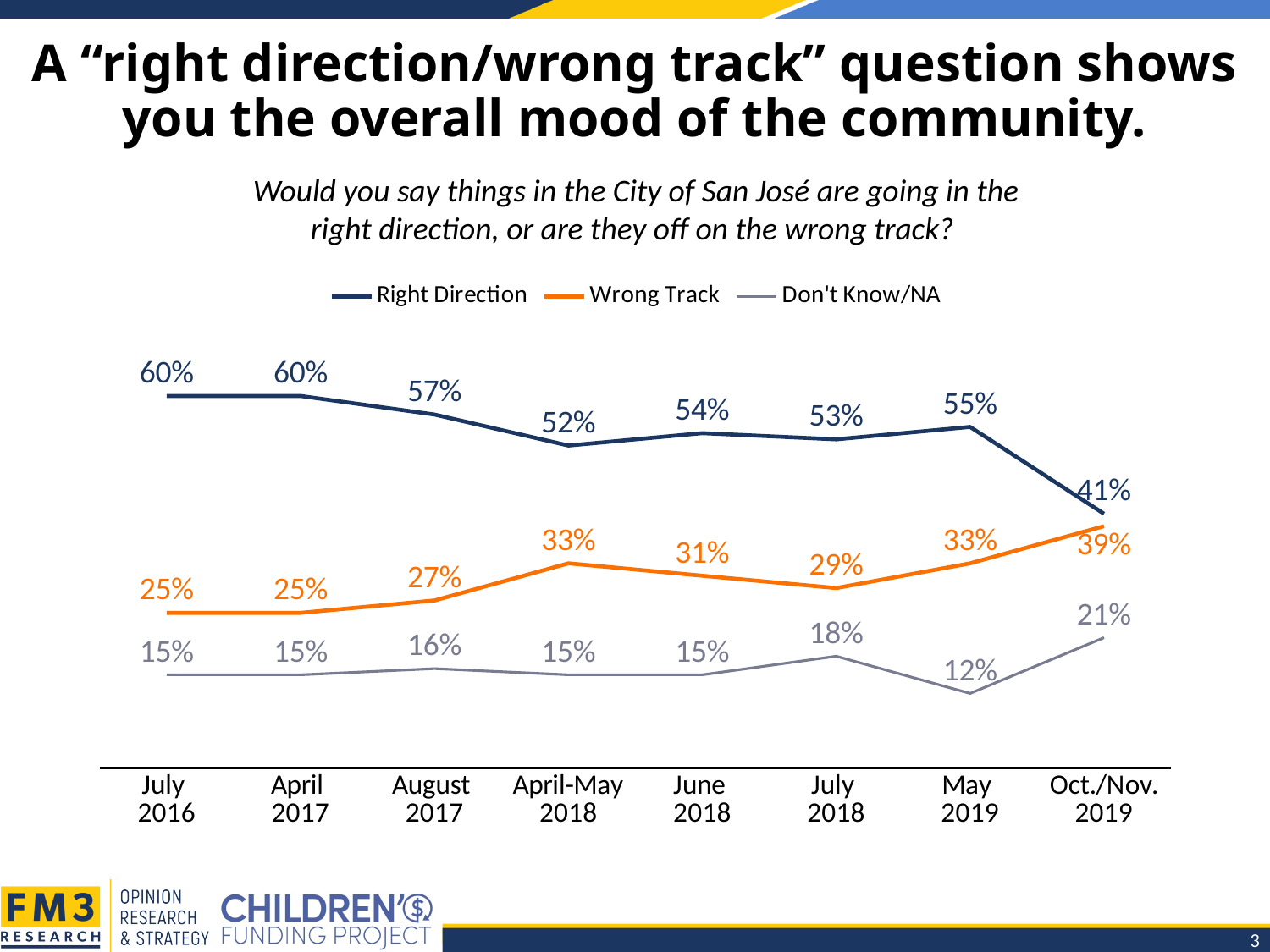
Which is larger in Oct./Nov. 2019, the Right Direction value or the Wrong Track value? Right Direction At which time point is the Wrong Track value highest? Oct./Nov. 2019 Which series is drawn in orange? Wrong Track How many time points are plotted along the x axis? 8 What kind of chart is shown on the slide? Line chart What is the difference between the Right Direction and Wrong Track values in July 2016? 35% How many series does the legend list? 3 What is the Wrong Track value for April-May 2018? 33% What is the Right Direction value for Oct./Nov. 2019? 41% Does the Wrong Track series generally rise or fall from July 2016 to Oct./Nov. 2019? Rise What is the Don't Know/NA value for May 2019? 12% At which time point is the Right Direction value lowest? Oct./Nov. 2019